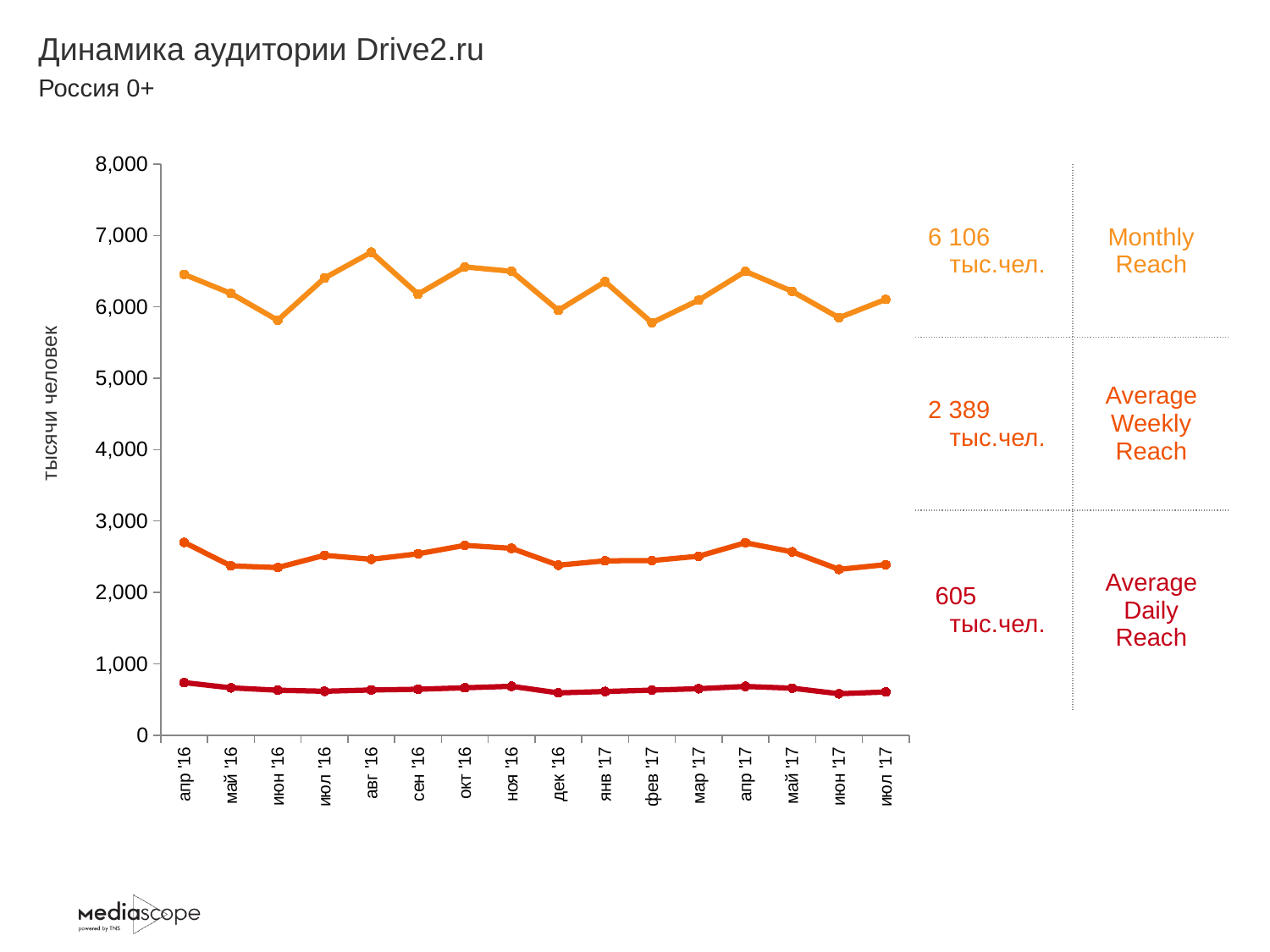
What Average Weekly Reach value is printed on the slide? 2 389 тыс.чел. What is the difference between the printed Monthly Reach value and the printed Average Weekly Reach value? 3 717 тыс.чел. What is the label on the vertical axis of the chart? тысячи человек Is the Average Daily Reach value for апр '16 greater or less than 1,000? less Is the Monthly Reach value for авг '16 greater or less than 6,000? greater What Average Daily Reach value is printed on the slide? 605 тыс.чел. What type of chart is shown on the slide? line chart In which month does the Monthly Reach line reach its highest point? авг '16 How many months are shown along the x axis of the chart? 16 How many lines (series) are plotted on the chart? 3 What is the title of the chart on the slide? Динамика аудитории Drive2.ru What Monthly Reach value is printed on the slide? 6 106 тыс.чел.